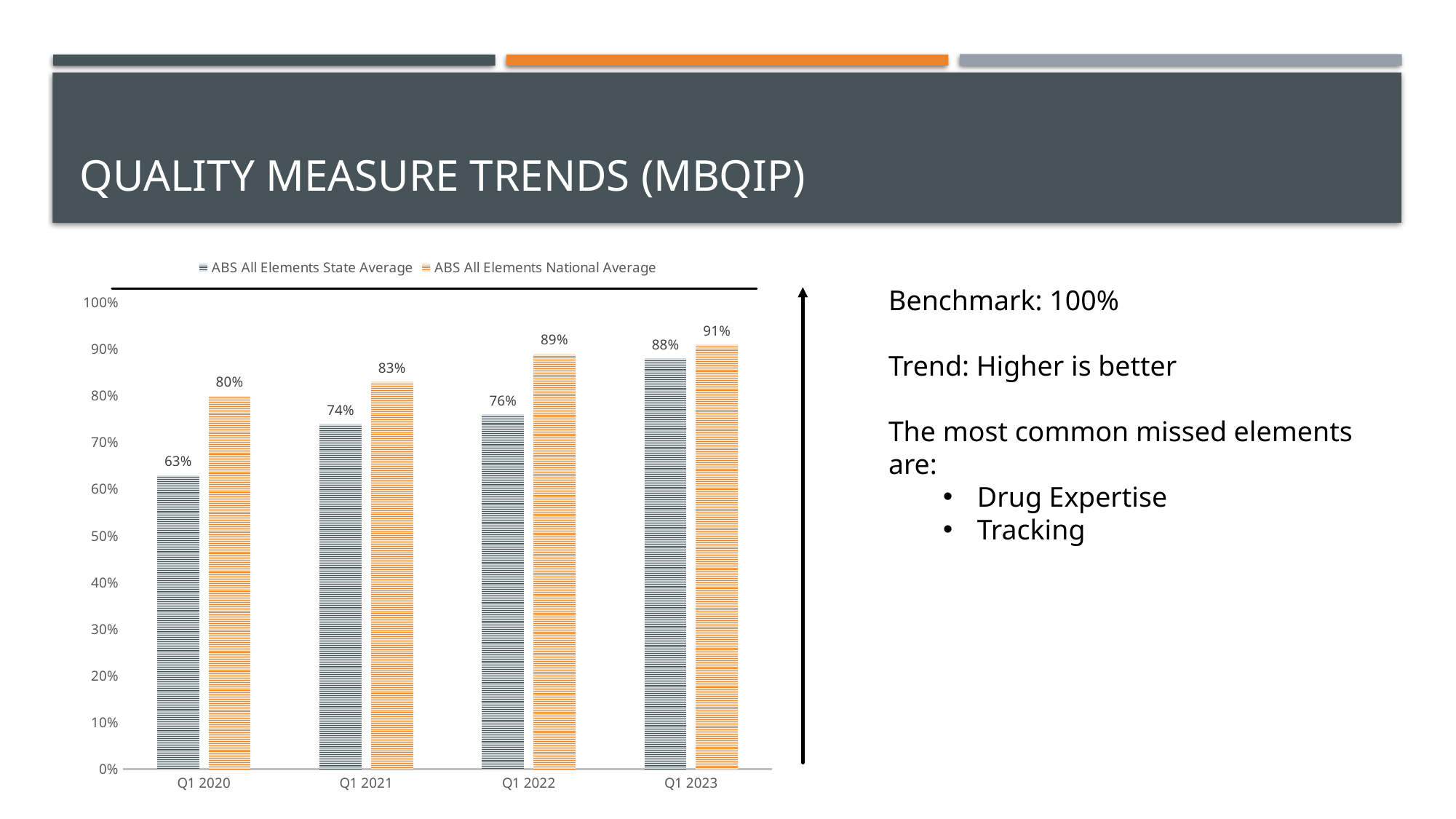
What is the difference between the National Average and the State Average in Q1 2020? 17% Does the ABS All Elements State Average rise or fall from Q1 2020 to Q1 2023? Rise In which quarter is the ABS All Elements National Average lowest? Q1 2020 How many quarters are shown on the x axis of the chart? 4 What kind of chart is shown on the slide? Bar chart In which quarter is the ABS All Elements State Average highest? Q1 2023 What is the ABS All Elements National Average for Q1 2022? 89% What is the ABS All Elements State Average for Q1 2020? 63% What is the difference between the State Average in Q1 2023 and the State Average in Q1 2022? 12% Which is larger in Q1 2021: the ABS All Elements State Average or the ABS All Elements National Average? ABS All Elements National Average How many series does the chart legend list? 2 What is the ABS All Elements State Average for Q1 2023? 88%